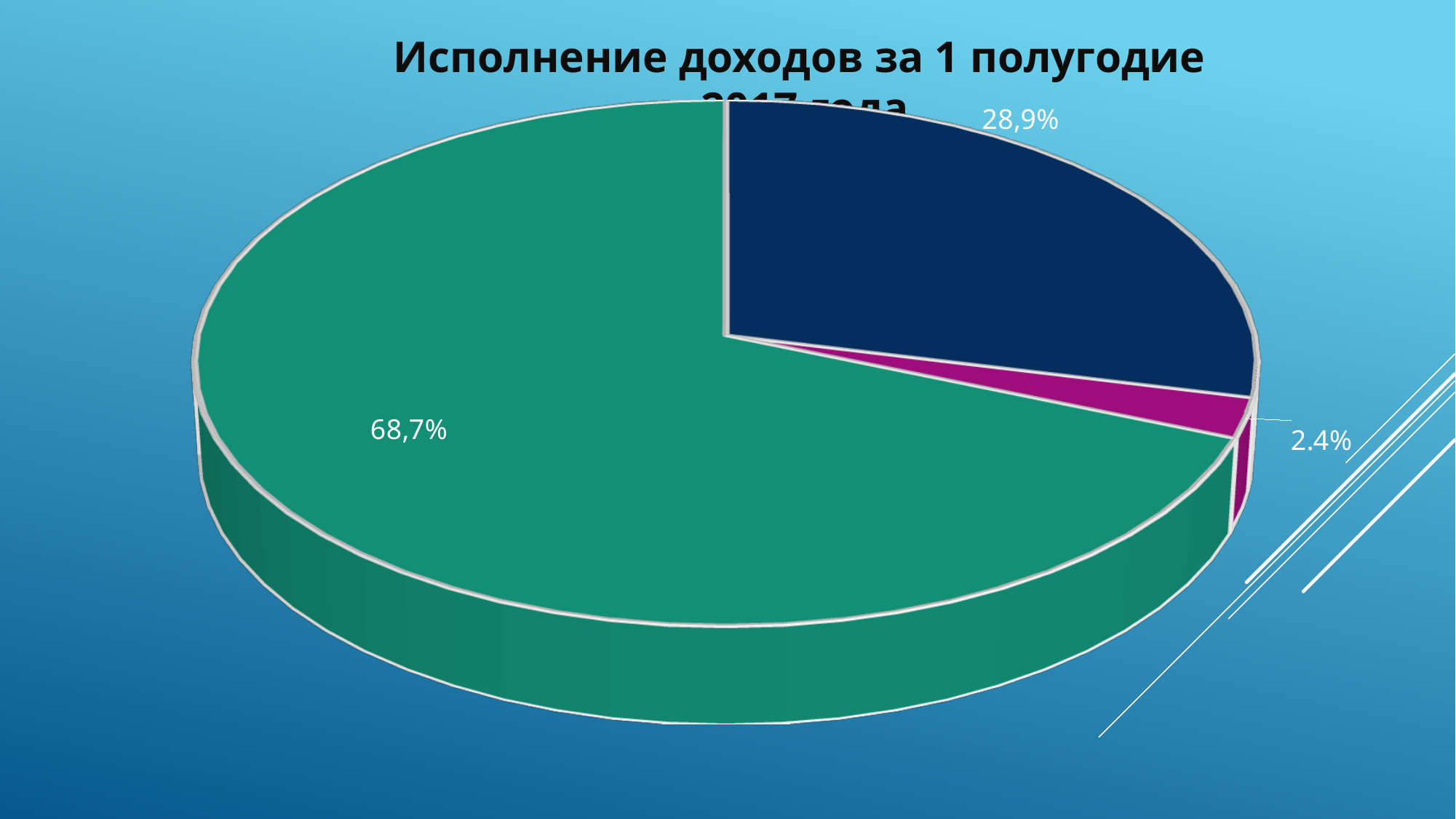
What kind of chart is shown on the slide? pie chart What percentage is shown for the dark blue slice of the pie chart? 28,9% Which is larger, the dark blue slice or the magenta slice? the dark blue slice Which slice of the pie chart is the smallest? the magenta slice (2.4%) How many slices does the pie chart have? 3 Is the green slice greater or less than half of the pie? greater What percentage is shown for the green slice of the pie chart? 68,7% What is the title of the chart? Исполнение доходов за 1 полугодие 2017 года What is the difference between the green slice and the dark blue slice? 39,8% What is the difference between the dark blue slice and the magenta slice? 26,5% Which slice of the pie chart is the largest? the green slice (68,7%) What percentage is shown for the magenta slice of the pie chart? 2.4%